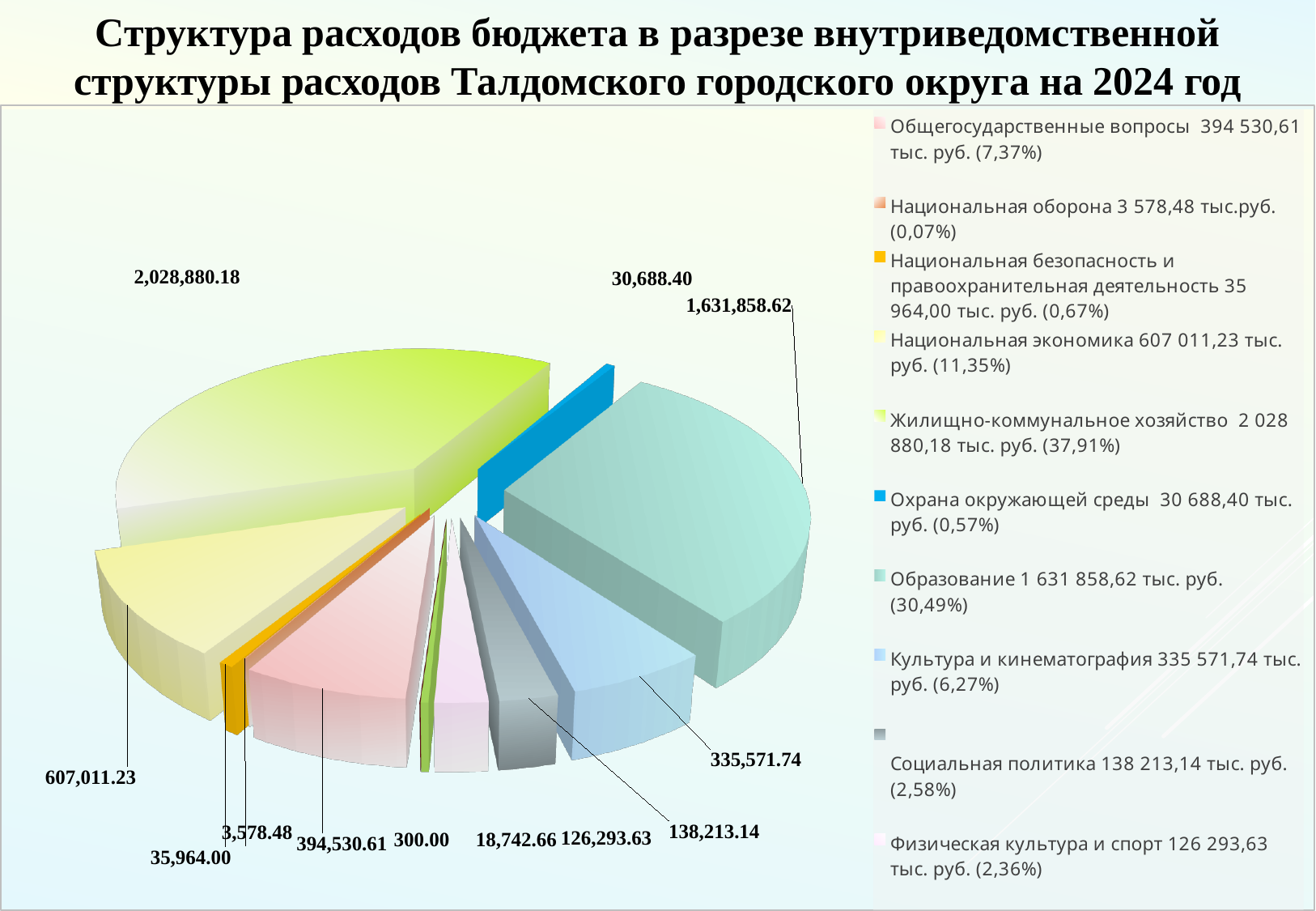
What share of the pie does Образование represent, according to the legend? 30,49% What is the value shown for Социальная политика? 138,213.14 What is the value shown for Национальная экономика? 607,011.23 What is the difference between the values for Общегосударственные вопросы and Культура и кинематография? 58,958.87 What is the value shown for Образование? 1,631,858.62 What share of the pie does Жилищно-коммунальное хозяйство represent, according to the legend? 37,91% Which category has the largest value in the pie chart? Жилищно-коммунальное хозяйство What is the difference between the values for Образование and Культура и кинематография? 1,296,286.88 How many entries does the legend list? 10 Among the categories listed in the legend, which has the smallest value? Национальная оборона Which is larger: Общегосударственные вопросы or Культура и кинематография? Общегосударственные вопросы What kind of chart is shown on the slide? Pie chart